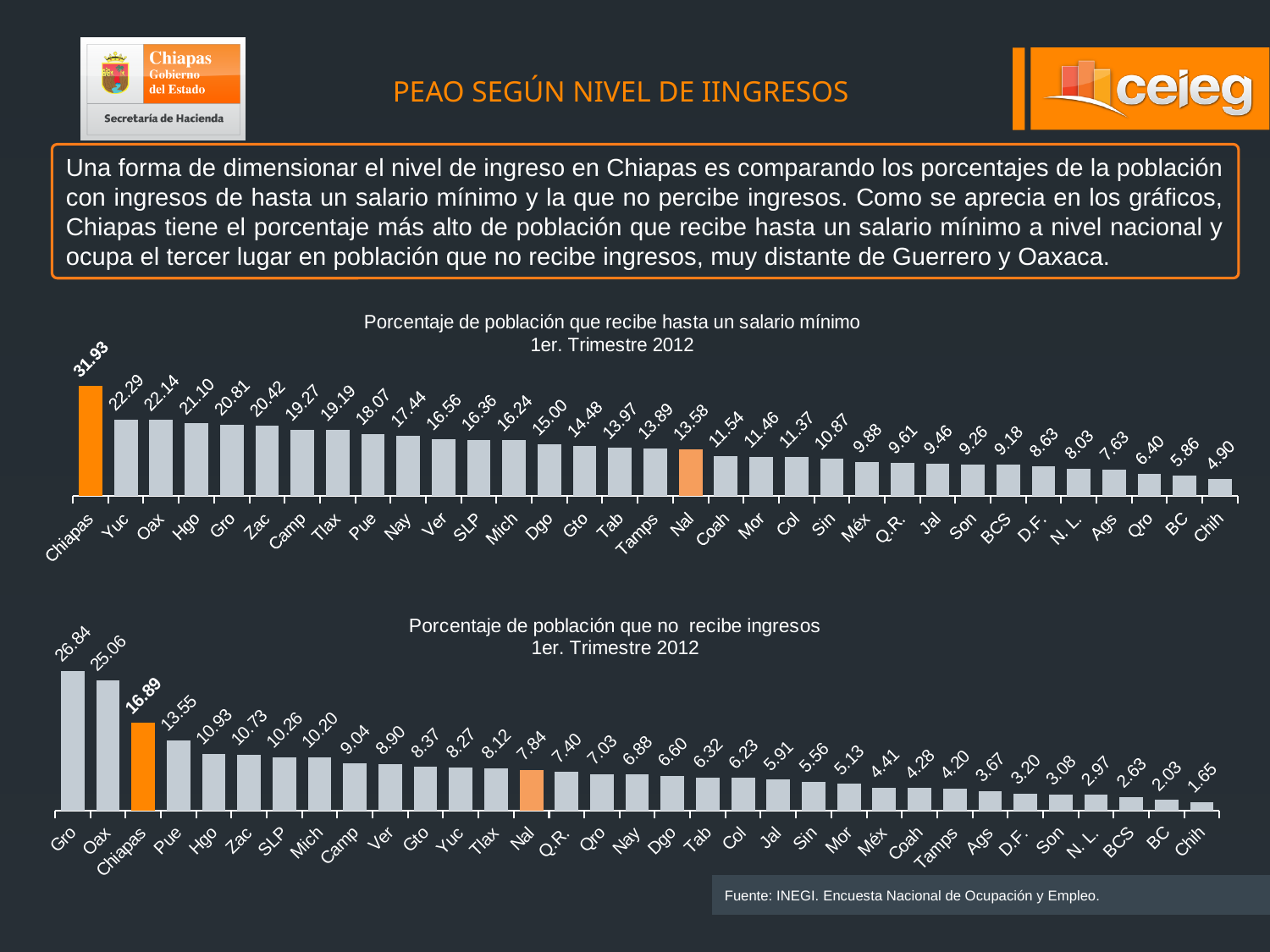
In the top chart (Porcentaje de población que recibe hasta un salario mínimo), what is the value for Nal? 13.58 In the bottom chart (Porcentaje de población que no recibe ingresos), which is larger, Jal or Sin? Jal In the bottom chart (Porcentaje de población que no recibe ingresos), what is the value for Nal? 7.84 In the top chart (Porcentaje de población que recibe hasta un salario mínimo), which is larger, Pue or Nay? Pue In the top chart (Porcentaje de población que recibe hasta un salario mínimo), what is the difference between Chiapas and Yuc? 9.64 In the top chart (Porcentaje de población que recibe hasta un salario mínimo), what is the value for Chiapas? 31.93 What kind of chart is the top chart on the slide? Bar chart In the bottom chart (Porcentaje de población que no recibe ingresos), do the values rise or fall from left to right? Fall In the top chart (Porcentaje de población que recibe hasta un salario mínimo), which category has the lowest value? Chih In the bottom chart (Porcentaje de población que no recibe ingresos), what is the difference between Gro and Oax? 1.78 In the bottom chart (Porcentaje de población que no recibe ingresos), which category has the highest value? Gro In the bottom chart (Porcentaje de población que no recibe ingresos), what is the value for Chiapas? 16.89